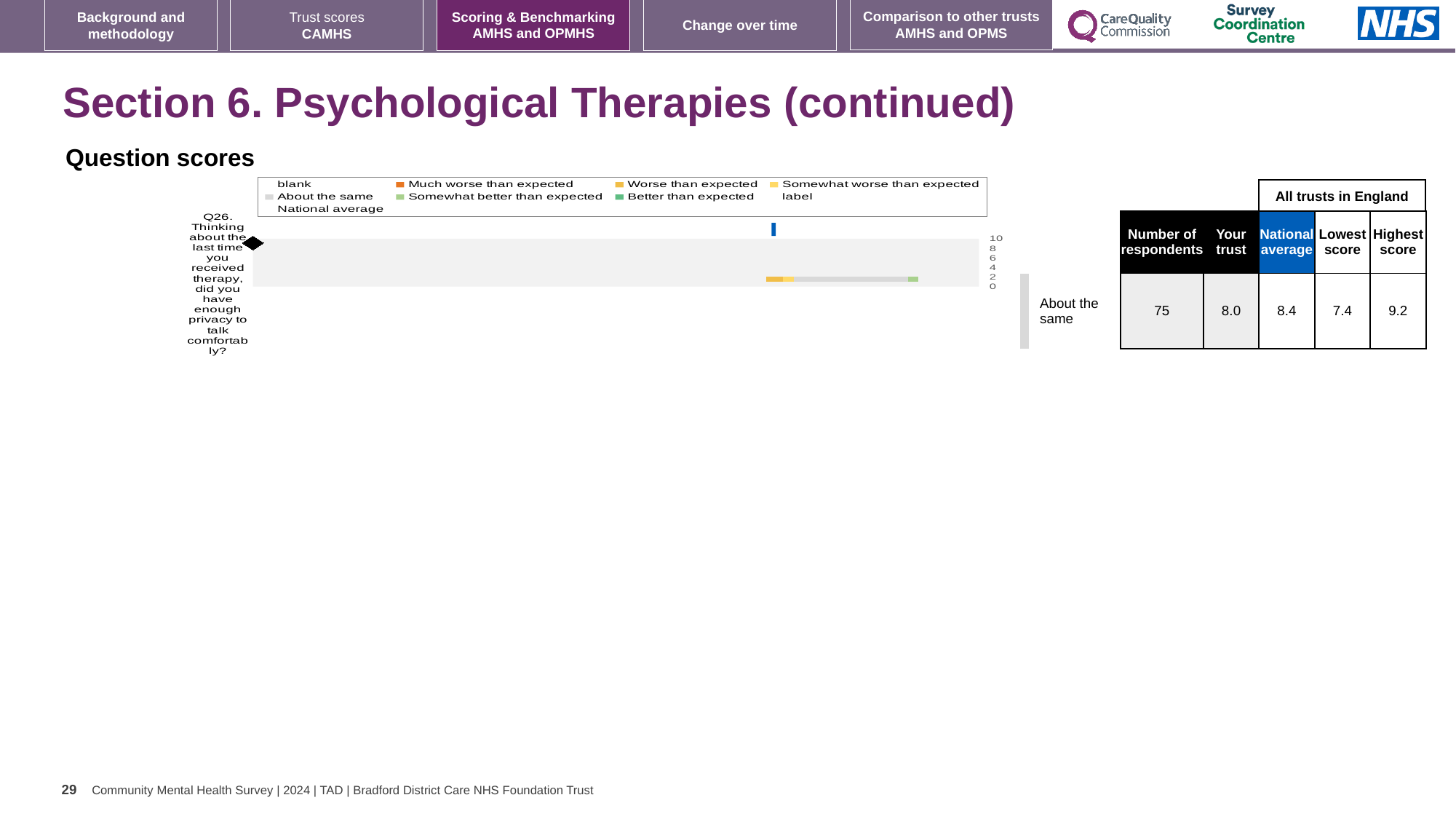
How many questions (categories) are plotted in the Question scores chart? 1 What is the difference between the highest score and the lowest score for Q26? 1.8 Which question is plotted in the Question scores chart? Q26. Thinking about the last time you received therapy, did you have enough privacy to talk comfortably? What is the highest score across all trusts in England for Q26? 9.2 What is the national average score for Q26? 8.4 What benchmark category is shown next to the Q26 bar? About the same What is the 'Your trust' score for Q26? 8.0 What is the lowest score across all trusts in England for Q26? 7.4 What is the number of respondents for Q26? 75 Which is larger for Q26, the 'Your trust' score or the national average? National average What kind of chart is shown under 'Question scores'? bar chart What is the difference between the national average and the 'Your trust' score for Q26? 0.4